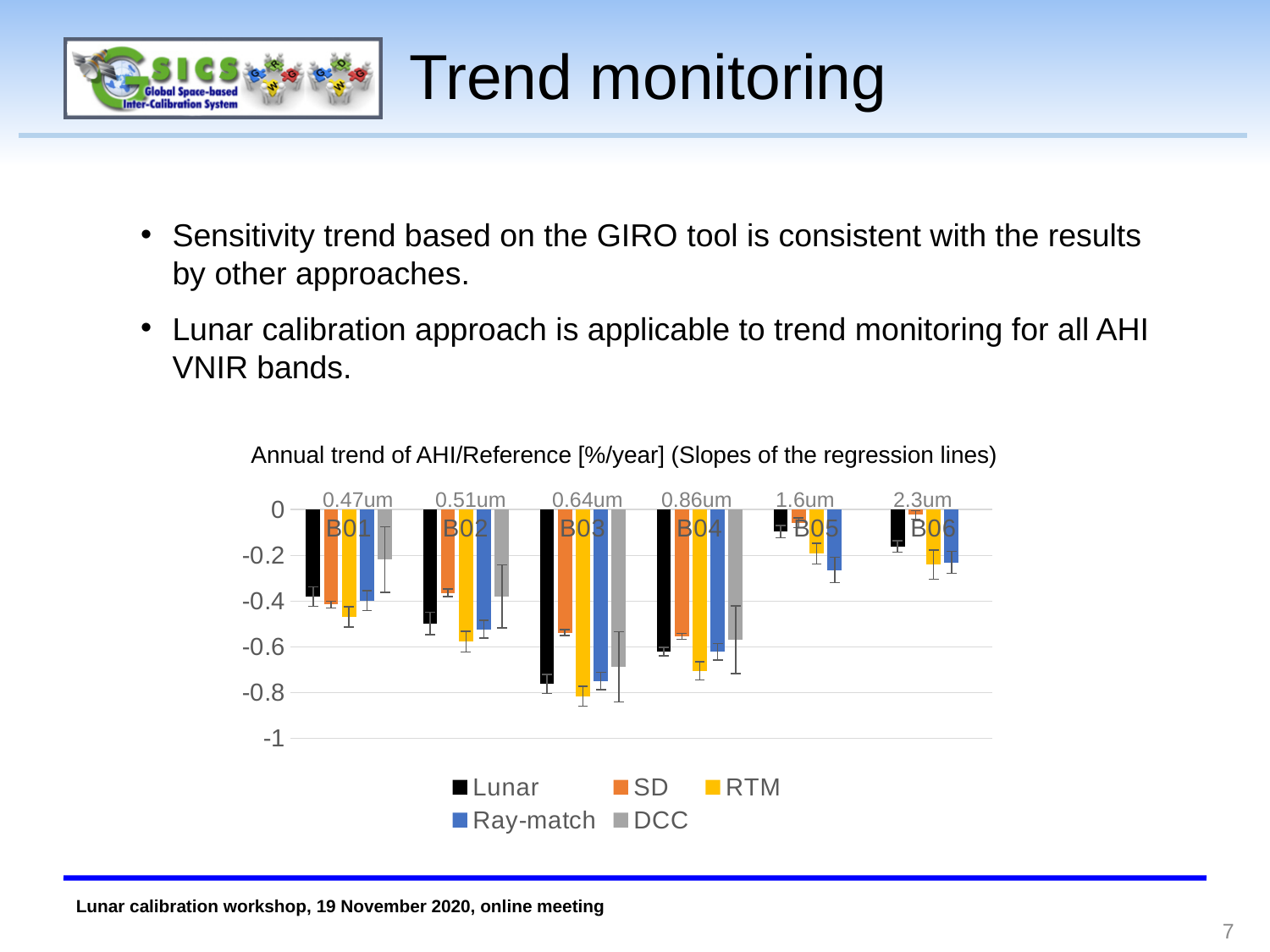
Which is larger, the SD value for B02 or the SD value for B03? B02 What is the title of the chart? Annual trend of AHI/Reference [%/year] (Slopes of the regression lines) Which is larger, the Lunar value for B01 or the Lunar value for B03? B01 Is the Lunar value for B01 greater or less than -0.6? greater Which band has the lowest (most negative) Lunar value in the chart? B03 Is the Lunar value for B03 greater or less than -0.6? less How many series does the chart legend list? 5 Which band has the highest (closest to zero) Lunar value in the chart? B05 What kind of chart is shown on the slide? bar chart How many bands (categories) are shown along the x axis of the chart? 6 Is the RTM value for B04 greater or less than -0.6? less Which wavelength is shown above the B03 category in the chart? 0.64um